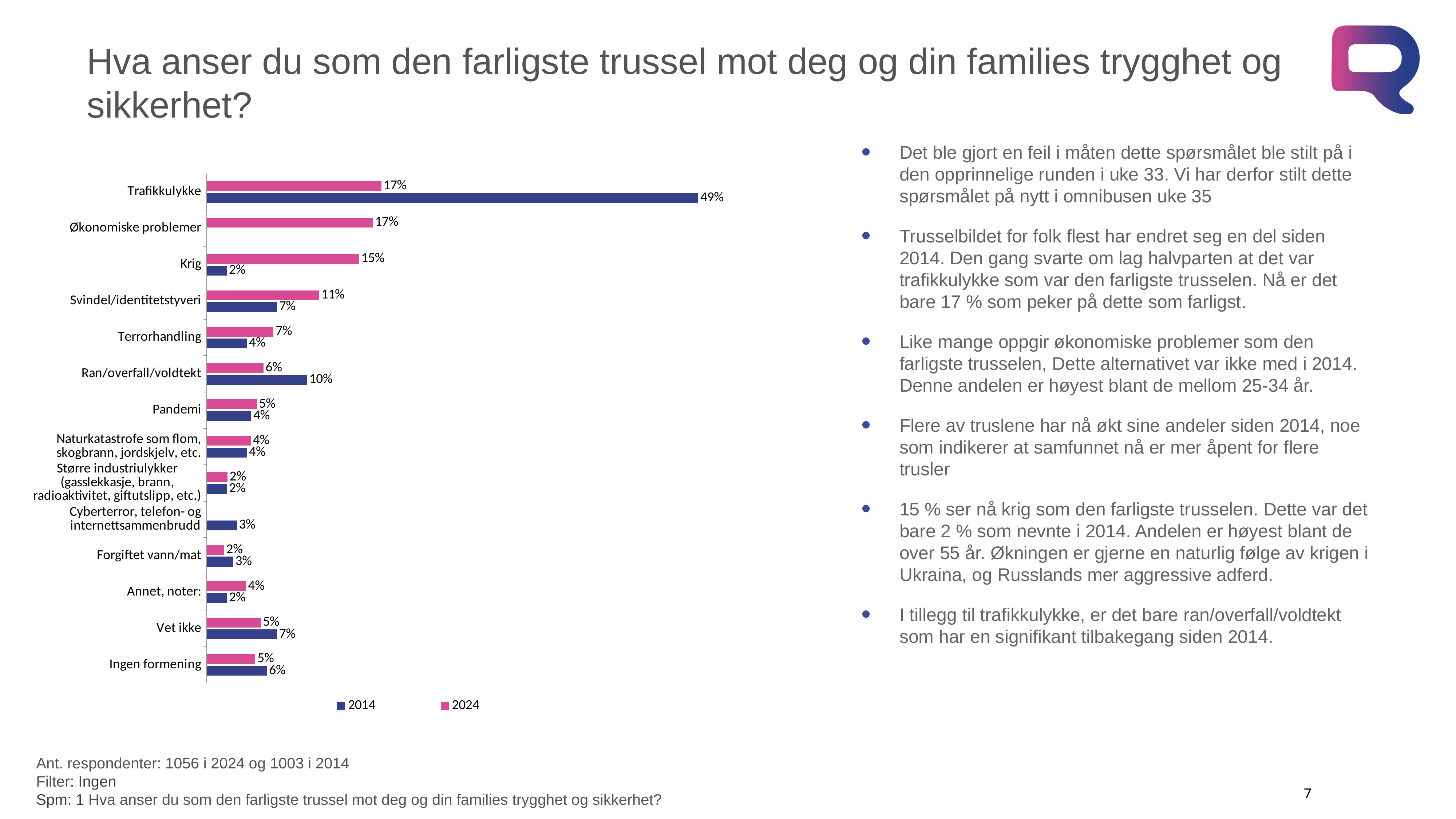
What is the difference between the 2014 and 2024 values for Trafikkulykke? 32 percentage points Which is larger for Terrorhandling: the 2014 value or the 2024 value? 2024 What is the value for Svindel/identitetstyveri in the 2024 series? 11% What is the value for Trafikkulykke in the 2014 series? 49% What is the value for Krig in the 2024 series? 15% How many series does the legend list? 2 What kind of chart is shown on the slide? Bar chart What is the difference between the 2024 and 2014 values for Krig? 13 percentage points Which is larger for Ran/overfall/voldtekt: the 2014 value or the 2024 value? 2014 How many categories are shown on the chart? 14 What is the value for Ran/overfall/voldtekt in the 2014 series? 10% Which category has the highest value in the 2014 series? Trafikkulykke